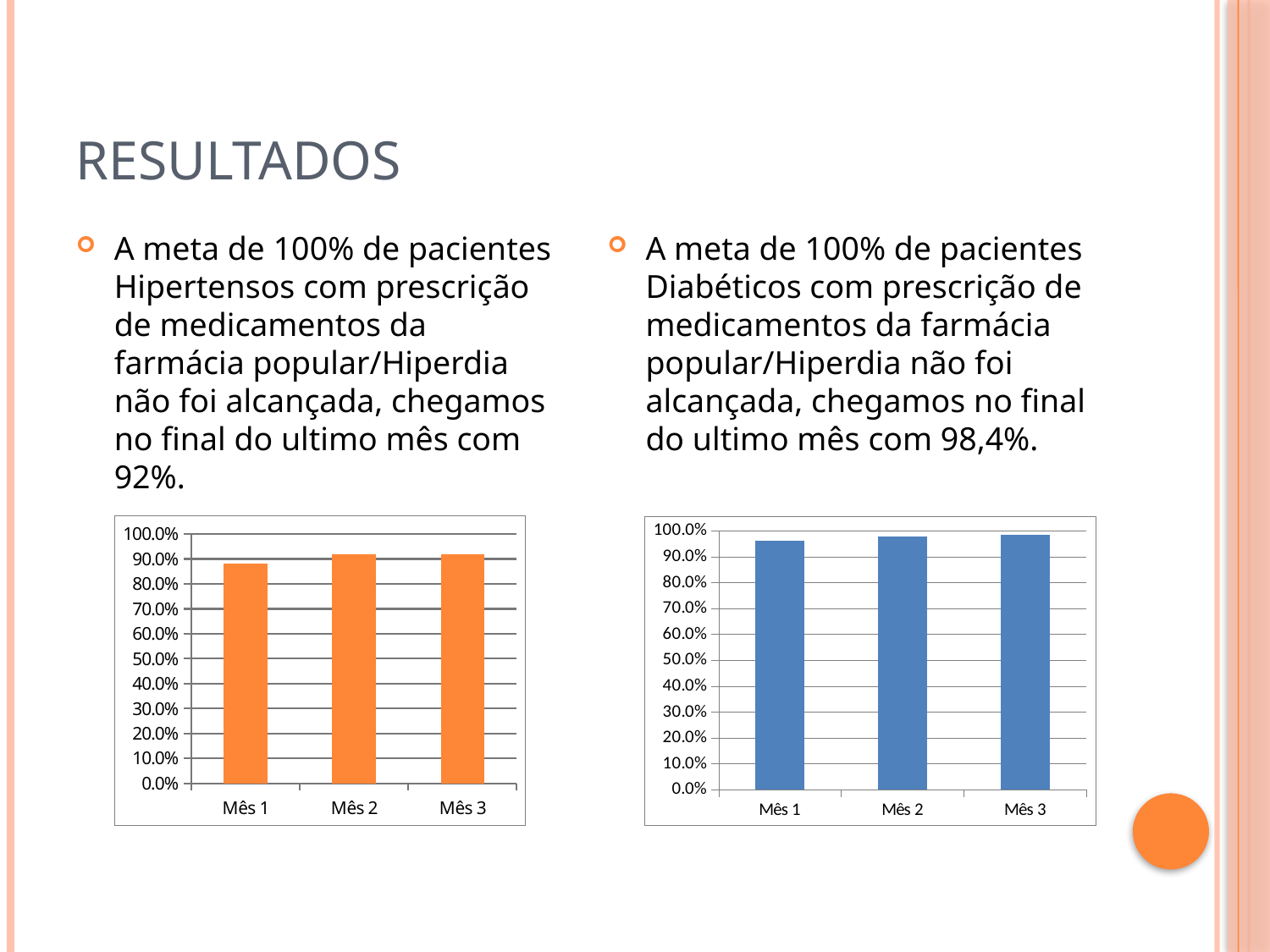
What colour are the bars in the left chart? orange What kind of chart is the left chart on the slide? bar chart In the left chart, is the value for Mês 2 larger or smaller than the value for Mês 1? larger How many bars does the right chart have? 3 In the right chart, is the value for Mês 1 greater or less than 90.0%? greater What kind of chart is the right chart on the slide? bar chart How many categories are shown on the x axis of the left chart? 3 In the left chart, which month has the lowest value? Mês 1 In the left chart, is the value for Mês 1 greater or less than 80.0%? greater In the right chart, which month has the lowest value? Mês 1 In the left chart, is the value for Mês 1 greater or less than 90.0%? less In the right chart, do the values rise or fall from Mês 1 to Mês 3? rise